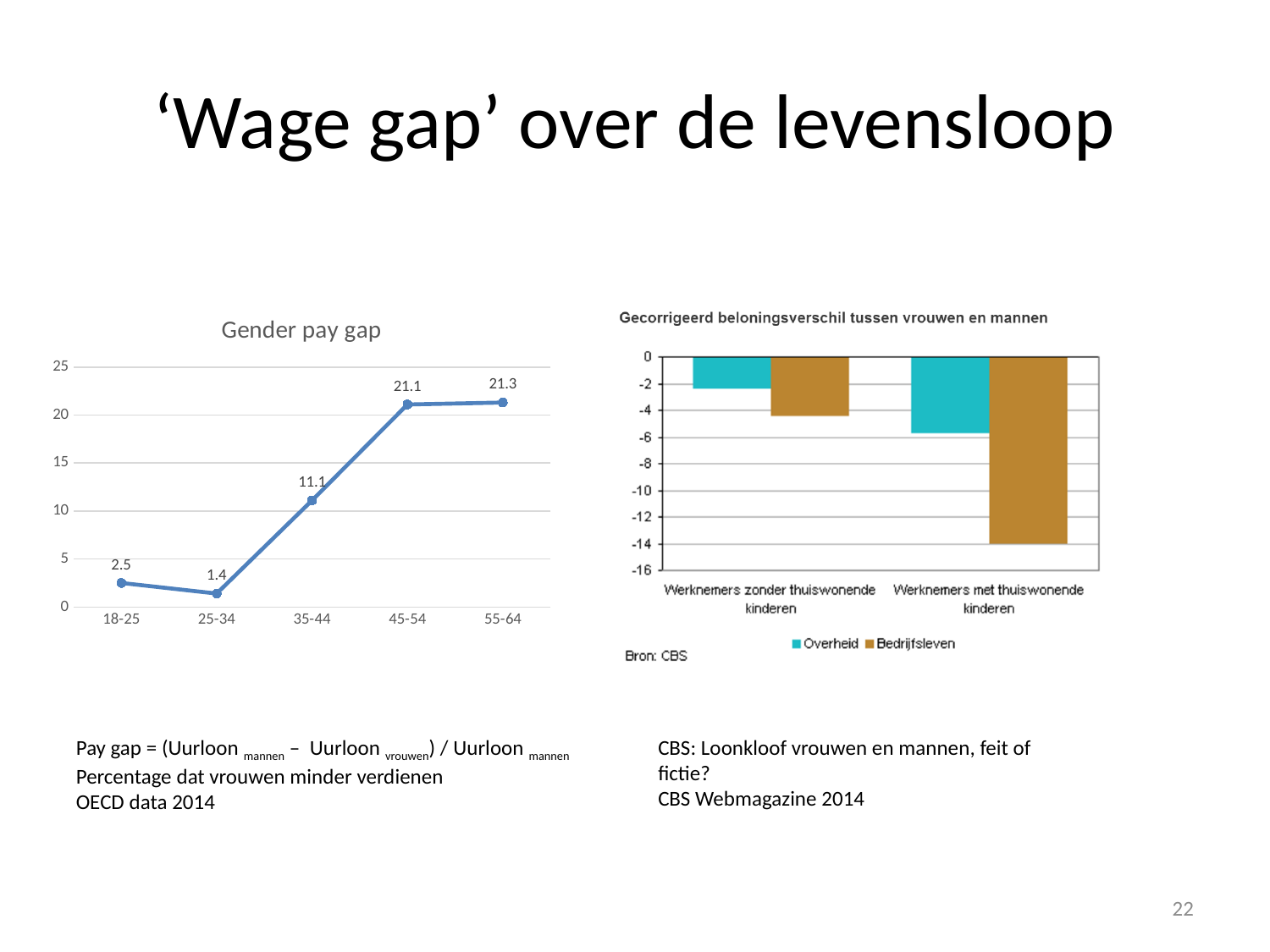
In the 'Gender pay gap' chart, what is the difference between the values for 45-54 and 35-44? 10.0 In the 'Gender pay gap' chart, what is the value for the 35-44 age group? 11.1 In the 'Gender pay gap' chart, do the values generally rise or fall from 25-34 to 55-64? rise In the 'Gecorrigeerd beloningsverschil tussen vrouwen en mannen' chart, is the Bedrijfsleven value for 'Werknemers met thuiswonende kinderen' greater or less than -10? less In the 'Gender pay gap' chart, what is the value for the 18-25 age group? 2.5 In the 'Gecorrigeerd beloningsverschil tussen vrouwen en mannen' chart, which series is shown in brown? Bedrijfsleven What kind of chart is the 'Gender pay gap' chart? line chart In the 'Gender pay gap' chart, which is larger: the value for 18-25 or the value for 25-34? 18-25 In the 'Gender pay gap' chart, which age group has the lowest value? 25-34 How many series does the legend of the 'Gecorrigeerd beloningsverschil tussen vrouwen en mannen' chart list? 2 In the 'Gender pay gap' chart, which age group has the highest value? 55-64 How many age groups are plotted in the 'Gender pay gap' chart? 5